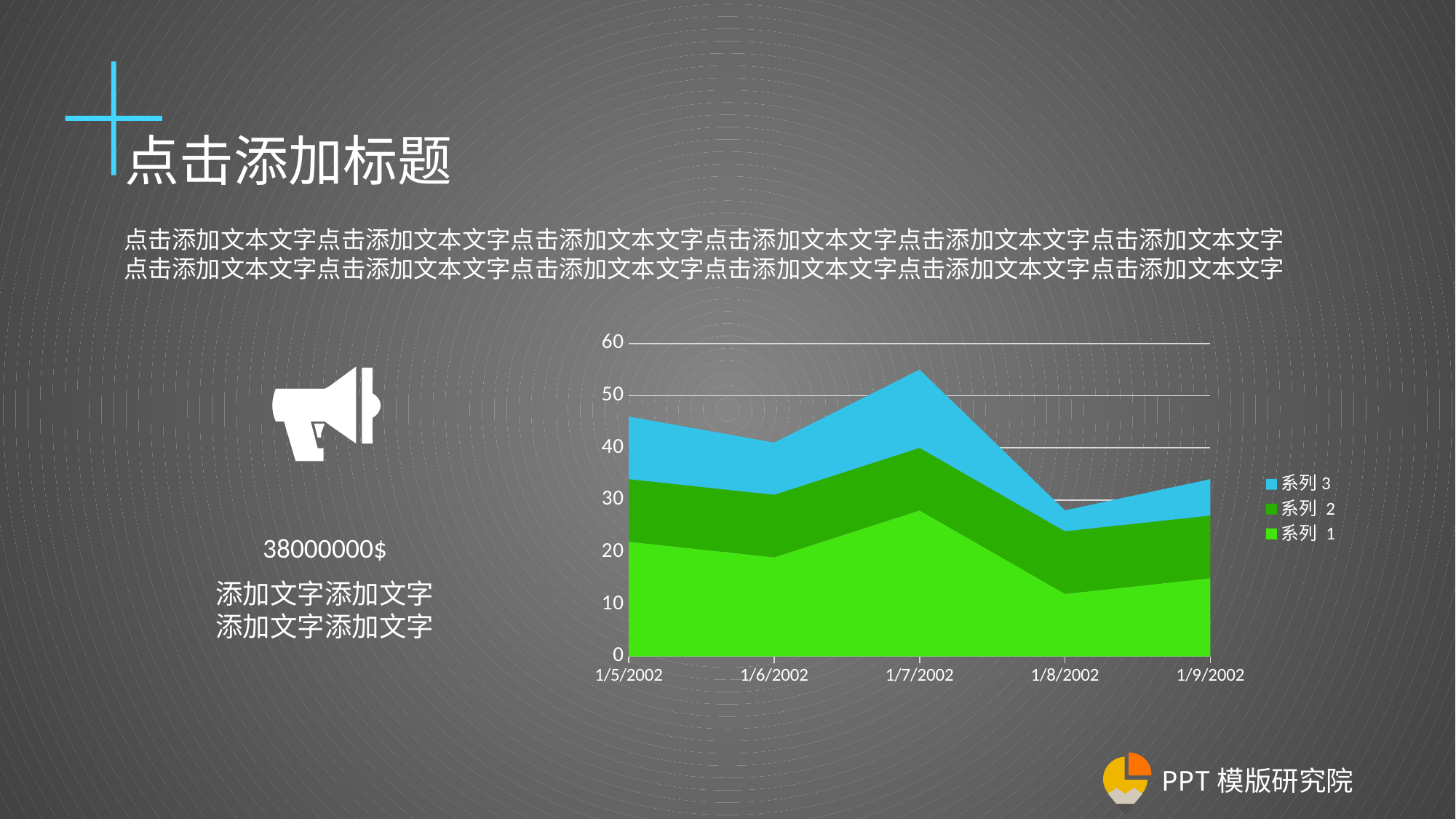
Which series is drawn in blue in the chart? 系列 3 How many dates are shown on the x axis of the chart? 5 What kind of chart is shown on the slide? Stacked area chart On which date does the stacked total of all series reach its lowest point? 1/8/2002 On which date does the stacked total of all series reach its highest point? 1/7/2002 Is the stacked total of all series at 1/7/2002 greater or less than 50? greater On which date is the value for 系列 1 lowest? 1/8/2002 Is the stacked total of all series at 1/5/2002 greater or less than 40? greater Does the stacked total of all series rise or fall from 1/7/2002 to 1/8/2002? fall Is the value for 系列 1 at 1/8/2002 greater or less than 20? less How many series does the chart's legend list? 3 On which date is the value for 系列 1 highest? 1/7/2002